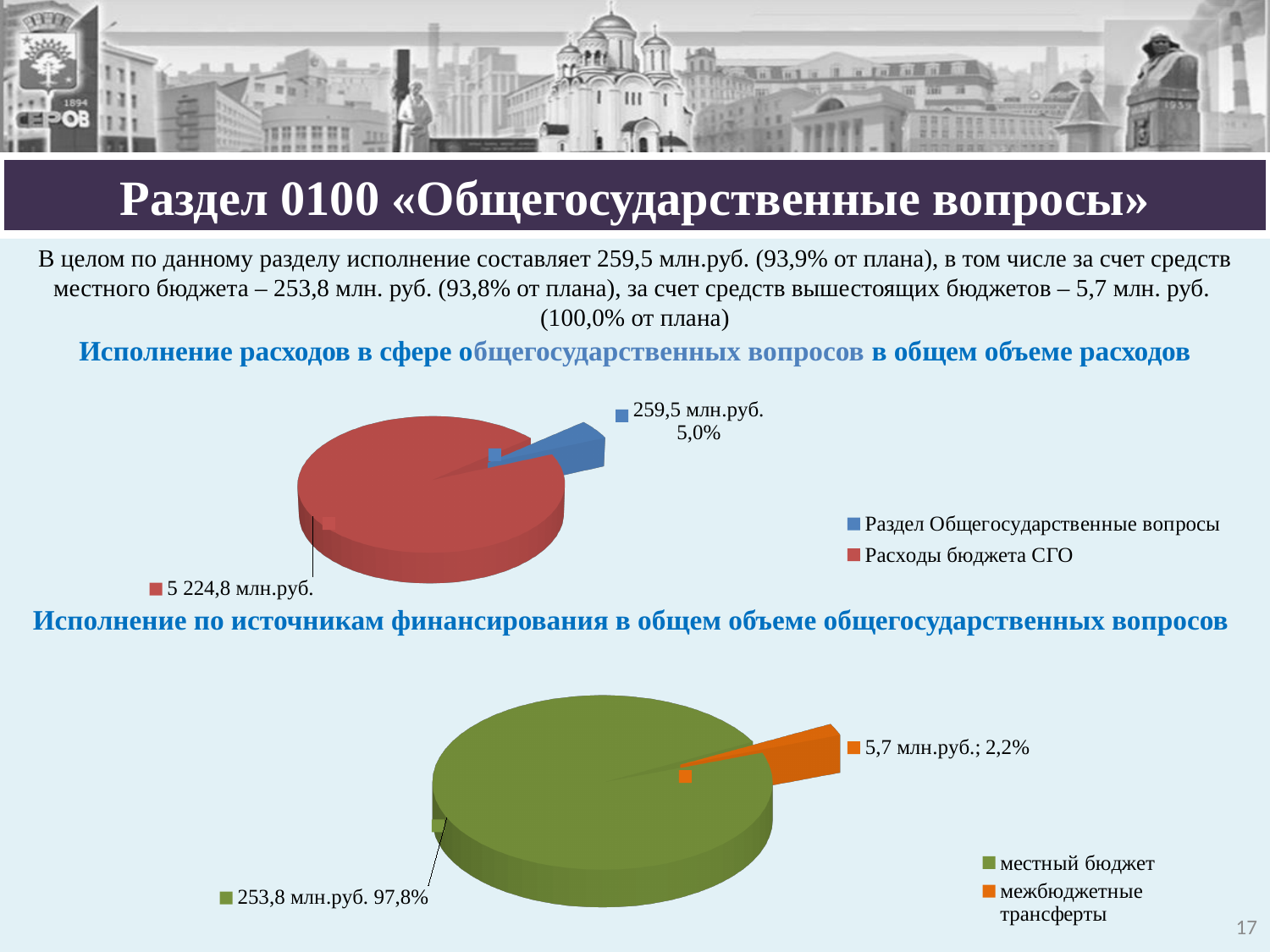
In the bottom pie chart, what colour is the slice for «местный бюджет»? Green In the top pie chart, what value is shown for «Раздел Общегосударственные вопросы»? 259,5 млн.руб. In the top pie chart, which slice is larger: «Раздел Общегосударственные вопросы» or «Расходы бюджета СГО»? Расходы бюджета СГО How many entries does the legend of the top pie chart list? 2 In the bottom pie chart titled «Исполнение по источникам финансирования в общем объеме общегосударственных вопросов», what value is shown for «местный бюджет»? 253,8 млн.руб. In the bottom pie chart, which slice is the smallest? межбюджетные трансферты In the bottom pie chart, what share of the pie does «межбюджетные трансферты» represent? 2,2% What type of chart is the top chart titled «Исполнение расходов в сфере общегосударственных вопросов в общем объеме расходов»? Pie chart In the top pie chart, what share of the pie does «Раздел Общегосударственные вопросы» represent? 5,0% In the top pie chart, what value is shown for «Расходы бюджета СГО»? 5 224,8 млн.руб. In the bottom pie chart, what share of the pie does «местный бюджет» represent? 97,8% In the bottom pie chart, what value is shown for «межбюджетные трансферты»? 5,7 млн.руб.